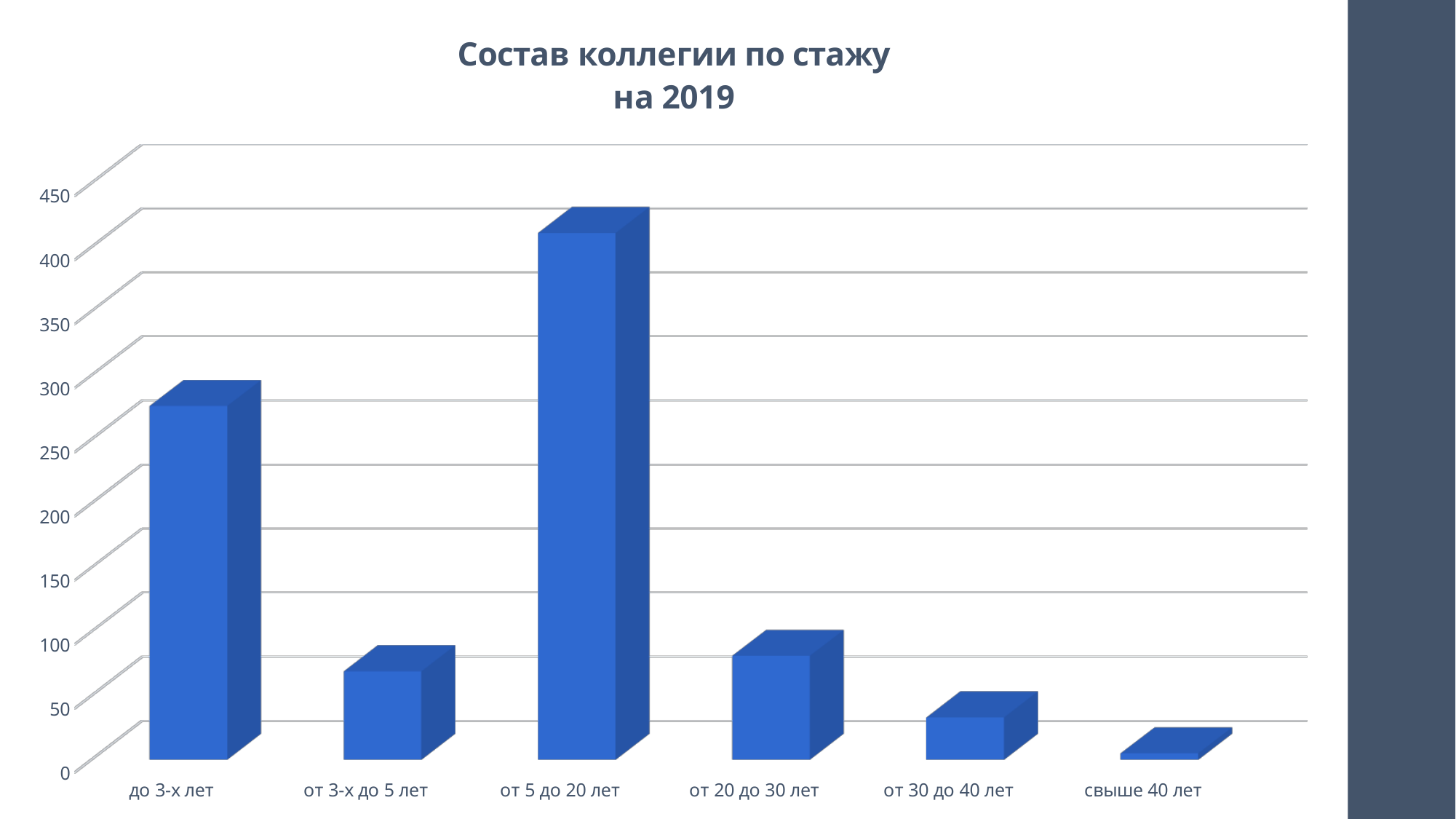
Is the value for от 5 до 20 лет greater or less than 400? greater Which category has the lowest value? свыше 40 лет What is the title of the chart? Состав коллегии по стажу на 2019 Which category has the highest value? от 5 до 20 лет Is the value for от 3-х до 5 лет greater or less than 100? less What kind of chart is shown on the slide? bar chart Is the value for свыше 40 лет greater or less than 50? less Which is larger, the value for от 3-х до 5 лет or the value for от 30 до 40 лет? от 3-х до 5 лет How many categories are shown on the x axis? 6 Which is larger, the value for до 3-х лет or the value for от 20 до 30 лет? до 3-х лет